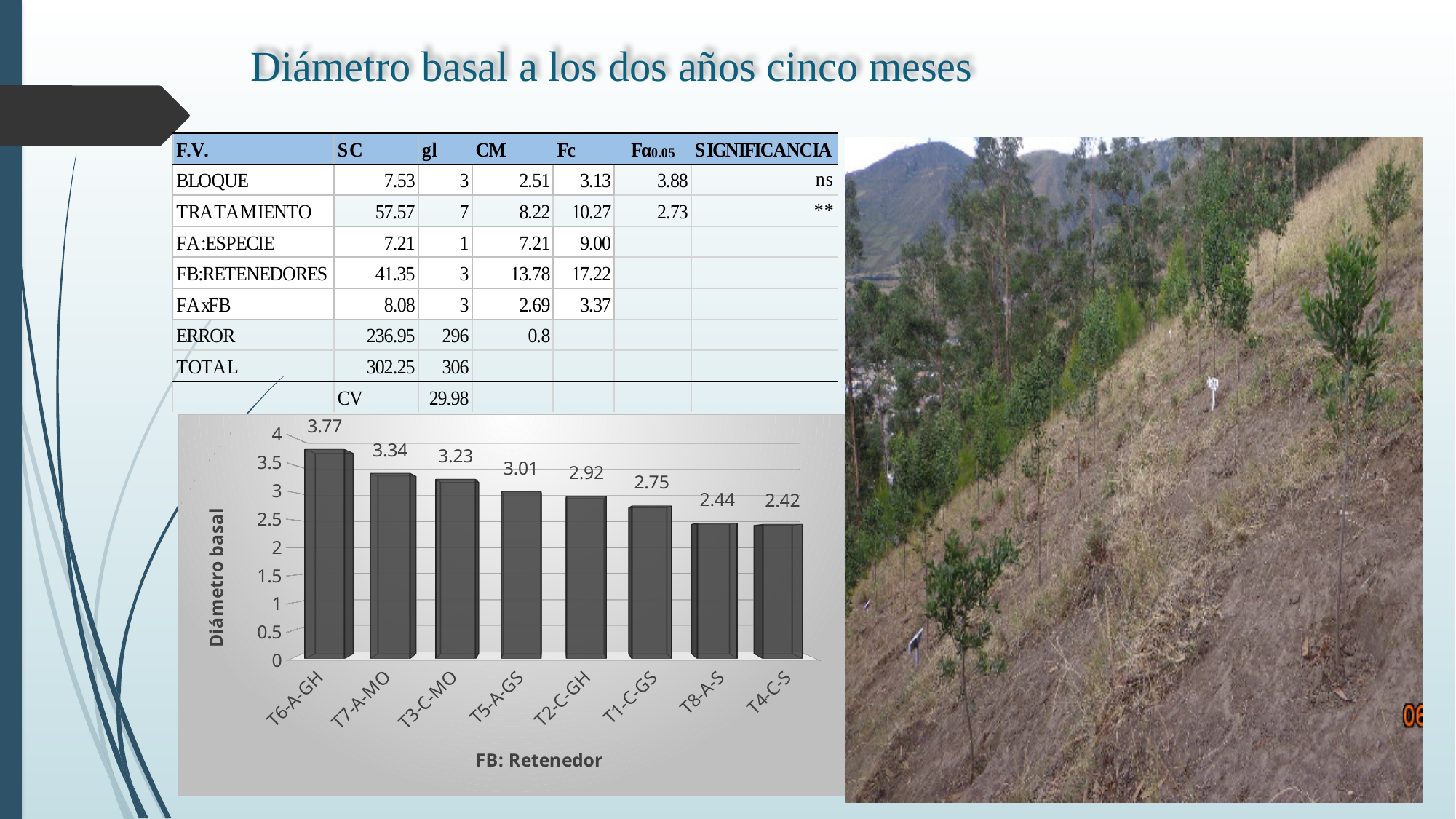
Do the values rise or fall from left to right along the x axis? fall Is the value for T8-A-S greater or less than 3? less How many categories are shown on the x axis of the chart? 8 Which is larger, the value for T7-A-MO or the value for T5-A-GS? T7-A-MO What is the difference between the values for T3-C-MO and T2-C-GH? 0.31 What is the diámetro basal value for T5-A-GS? 3.01 Which category has the highest diámetro basal? T6-A-GH What is the diámetro basal value for T6-A-GH? 3.77 What is the diámetro basal value for T1-C-GS? 2.75 What kind of chart is shown on the slide? bar chart What is the difference between the values for T6-A-GH and T7-A-MO? 0.43 Which category has the lowest diámetro basal? T4-C-S